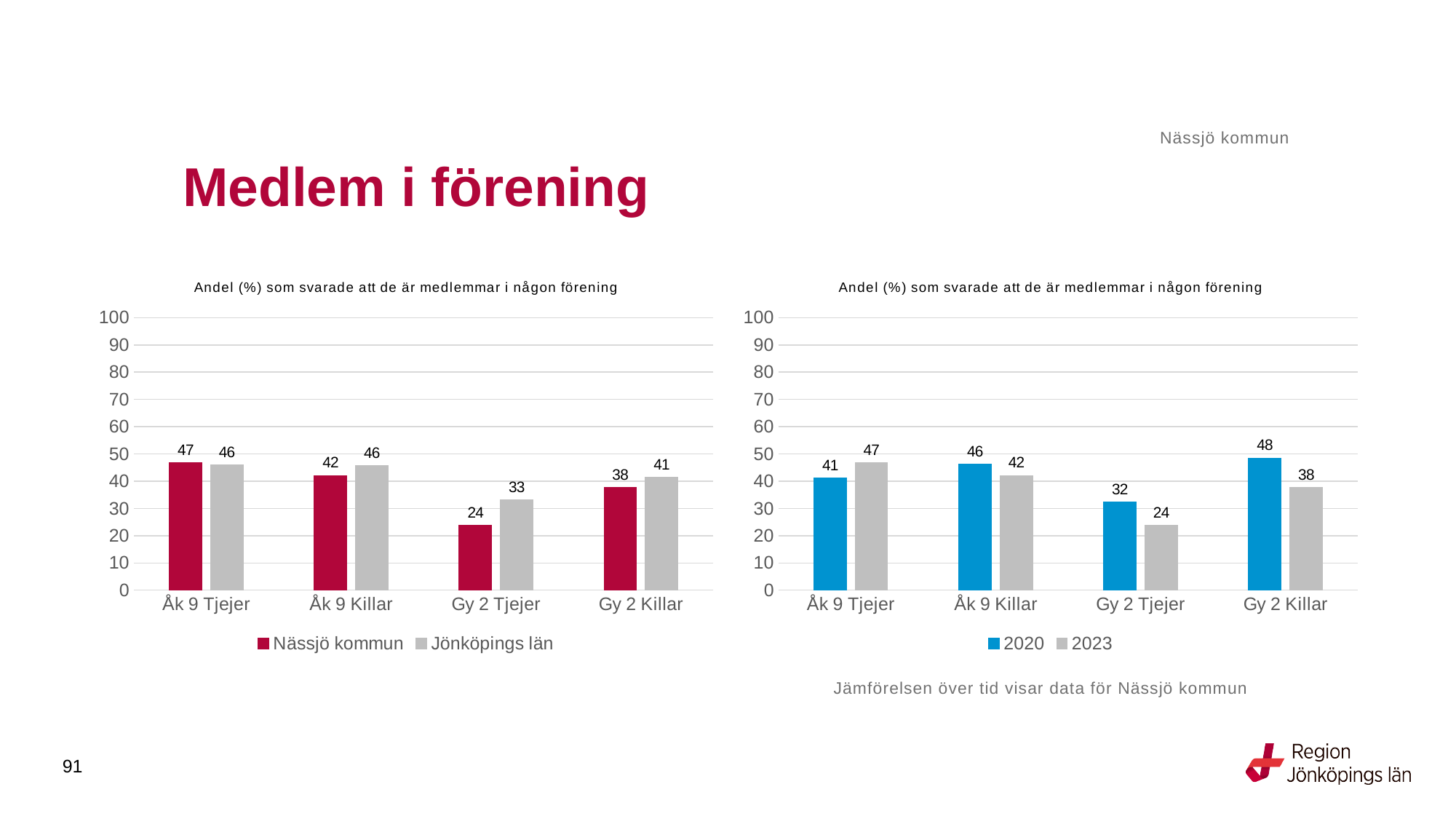
In the right chart, what is the value for 2023 for Gy 2 Tjejer? 24 In the left chart, what is the difference between Jönköpings län and Nässjö kommun for Gy 2 Tjejer? 9 In the left chart, which category has the lowest value for Nässjö kommun? Gy 2 Tjejer In the right chart, what is the difference between 2020 and 2023 for Gy 2 Killar? 10 In the right chart, which category has the highest value for 2020? Gy 2 Killar In the left chart, which is larger for Åk 9 Killar: Nässjö kommun or Jönköpings län? Jönköpings län How many series does the legend of the left chart list? 2 In the left chart, what is the value for Nässjö kommun for Åk 9 Tjejer? 47 In the left chart, what is the value for Jönköpings län for Gy 2 Tjejer? 33 How many categories are shown on the x axis of the right chart? 4 In the right chart, what is the value for 2020 for Gy 2 Killar? 48 What kind of chart is the right chart? Bar chart